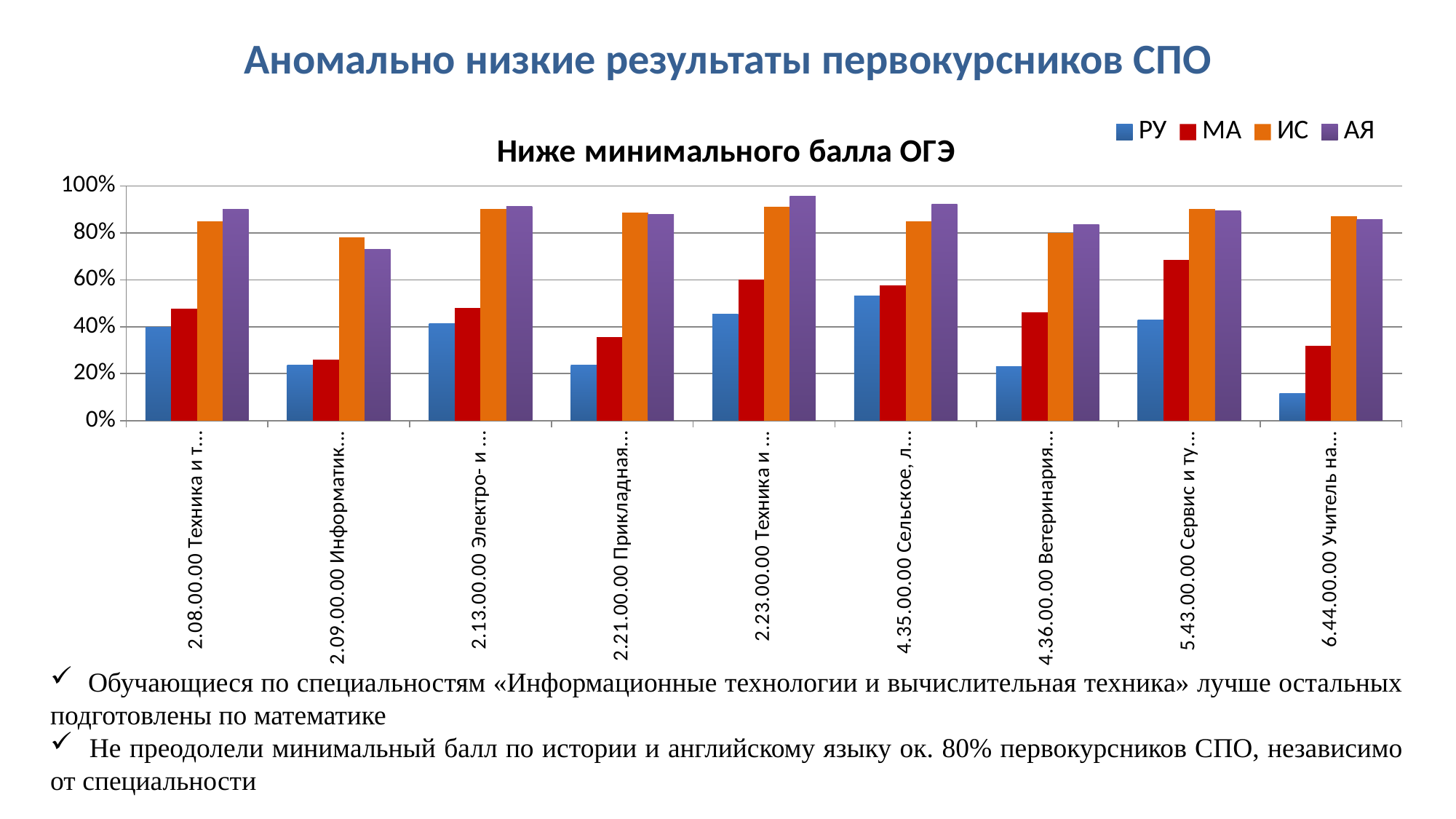
What is the title of the chart? Ниже минимального балла ОГЭ How many series does the legend of the chart list? 4 Is the РУ value for the category 6.44.00.00 greater or less than 20%? less Which series are listed in the chart legend? РУ, МА, ИС, АЯ Is the АЯ value for the category 2.23.00.00 greater or less than 80%? greater Which category has the lowest РУ value? 6.44.00.00 Учитель на... Which category has the highest РУ value? 4.35.00.00 Сельское, л... Is the АЯ value for the category 2.09.00.00 greater or less than 80%? less How many categories (specialty groups) are shown on the x axis of the chart? 9 For the category 5.43.00.00, which is larger: the РУ value or the МА value? МА What kind of chart is shown on the slide? bar chart